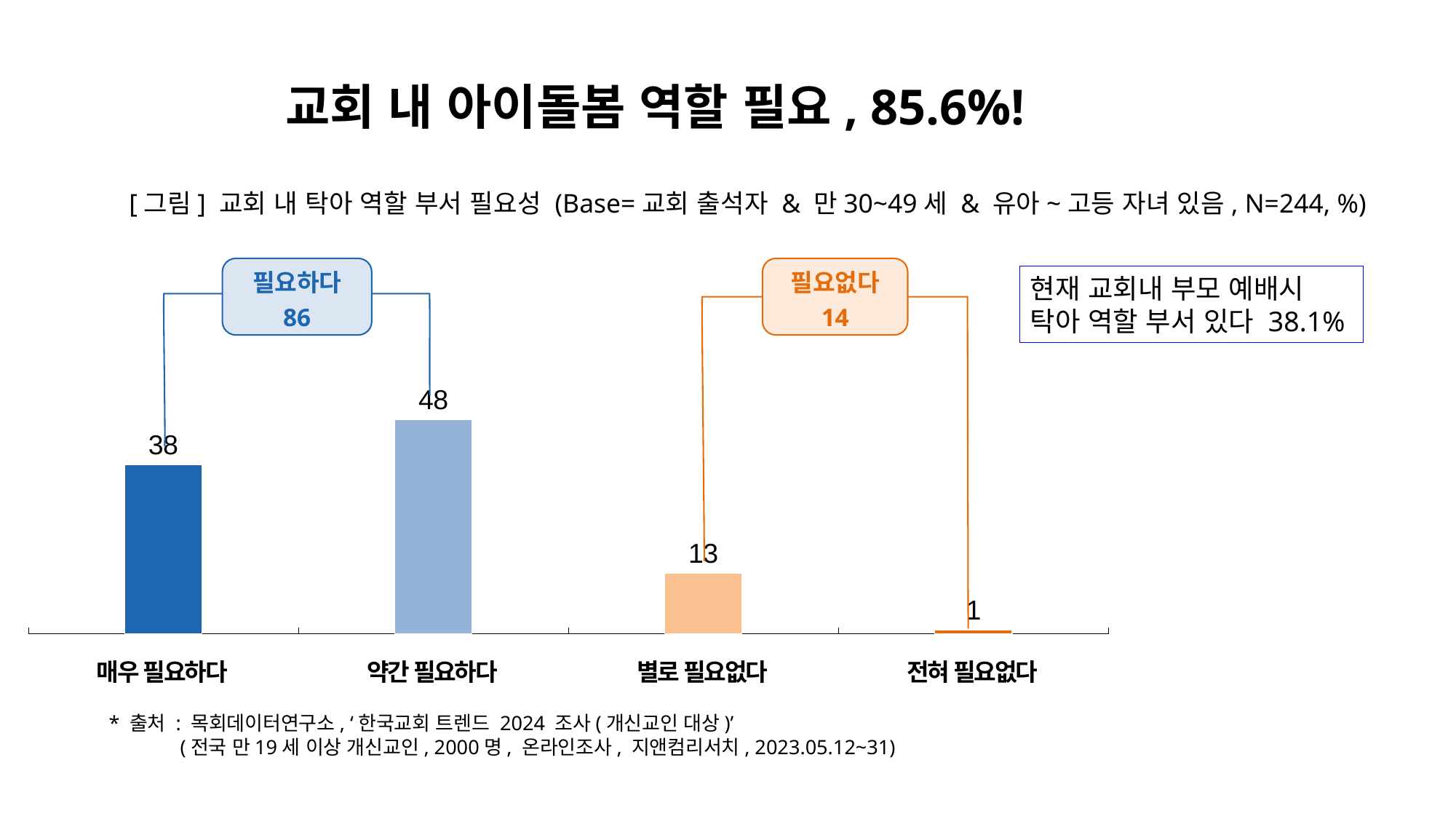
What is the value for 매우 필요하다? 38 Which is larger, the value for 매우 필요하다 or the value for 별로 필요없다? 매우 필요하다 What is the combined value shown in the 필요하다 box? 86 What kind of chart is this? bar chart What is the value for 전혀 필요없다? 1 What is the value for 약간 필요하다? 48 Which category has the highest value? 약간 필요하다 What is the combined value shown in the 필요없다 box? 14 What is the difference between the values for 약간 필요하다 and 매우 필요하다? 10 How many categories are shown on the x axis? 4 What is the value for 별로 필요없다? 13 Which category has the lowest value? 전혀 필요없다